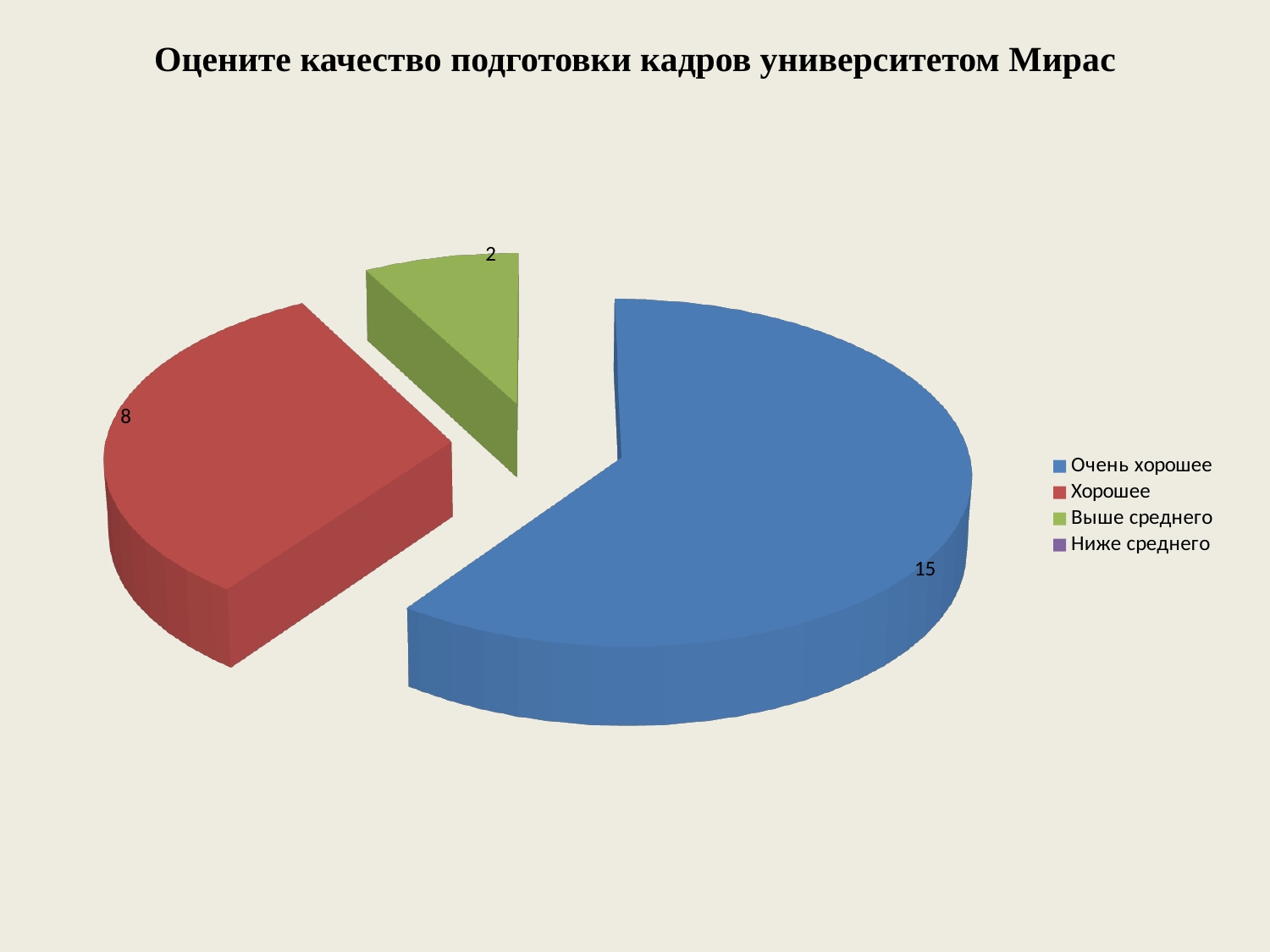
How many categories does the legend list? 4 Which is larger, the value for "Хорошее" or the value for "Выше среднего"? Хорошее What is the value for "Выше среднего"? 2 Which labelled slice has the smallest value? Выше среднего What is the difference between the values for "Хорошее" and "Выше среднего"? 6 What is the value for "Хорошее"? 8 What is the title of the chart? Оцените качество подготовки кадров университетом Мирас What is the value for "Очень хорошее"? 15 What type of chart is shown on the slide? Pie chart Which category has the largest slice of the pie? Очень хорошее What is the difference between the values for "Очень хорошее" and "Хорошее"? 7 What colour is the slice for "Очень хорошее"? Blue